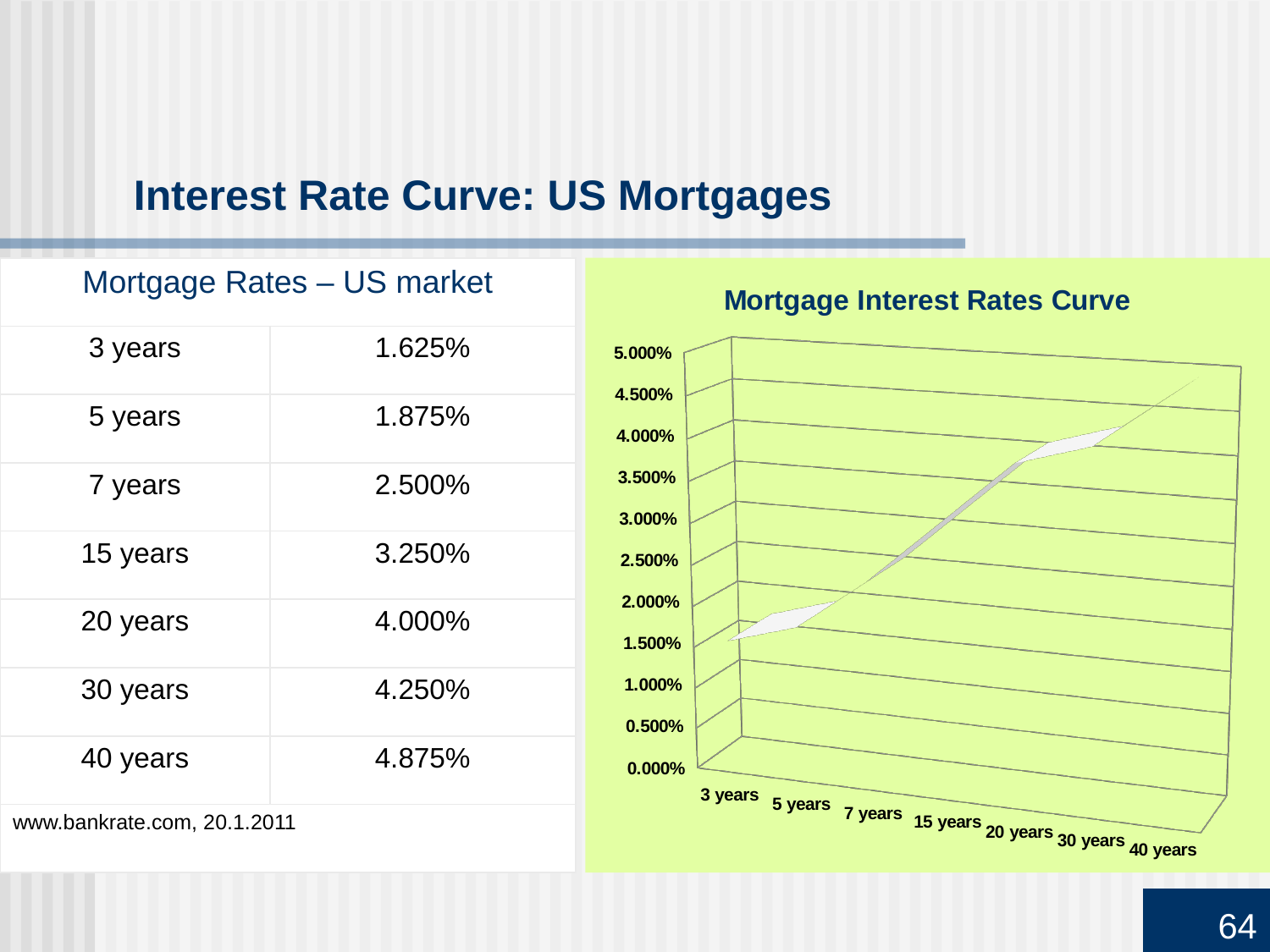
Which category has the highest value in the Mortgage Interest Rates Curve chart? 40 years Is the value for 3 years in the Mortgage Interest Rates Curve chart greater or less than 2.000%? less How many categories are shown on the x axis of the Mortgage Interest Rates Curve chart? 7 Do the values in the Mortgage Interest Rates Curve chart rise or fall from 3 years to 40 years? rise Which is larger, the rate for 7 years or the rate for 30 years? 30 years What is the title of the chart on the slide? Mortgage Interest Rates Curve What is the mortgage rate for 3 years? 1.625% What is the mortgage rate for 15 years? 3.250% What kind of chart is the Mortgage Interest Rates Curve? line chart Which category has the lowest value in the Mortgage Interest Rates Curve chart? 3 years What is the mortgage rate for 40 years? 4.875% What is the difference between the 40 years rate and the 3 years rate? 3.250%